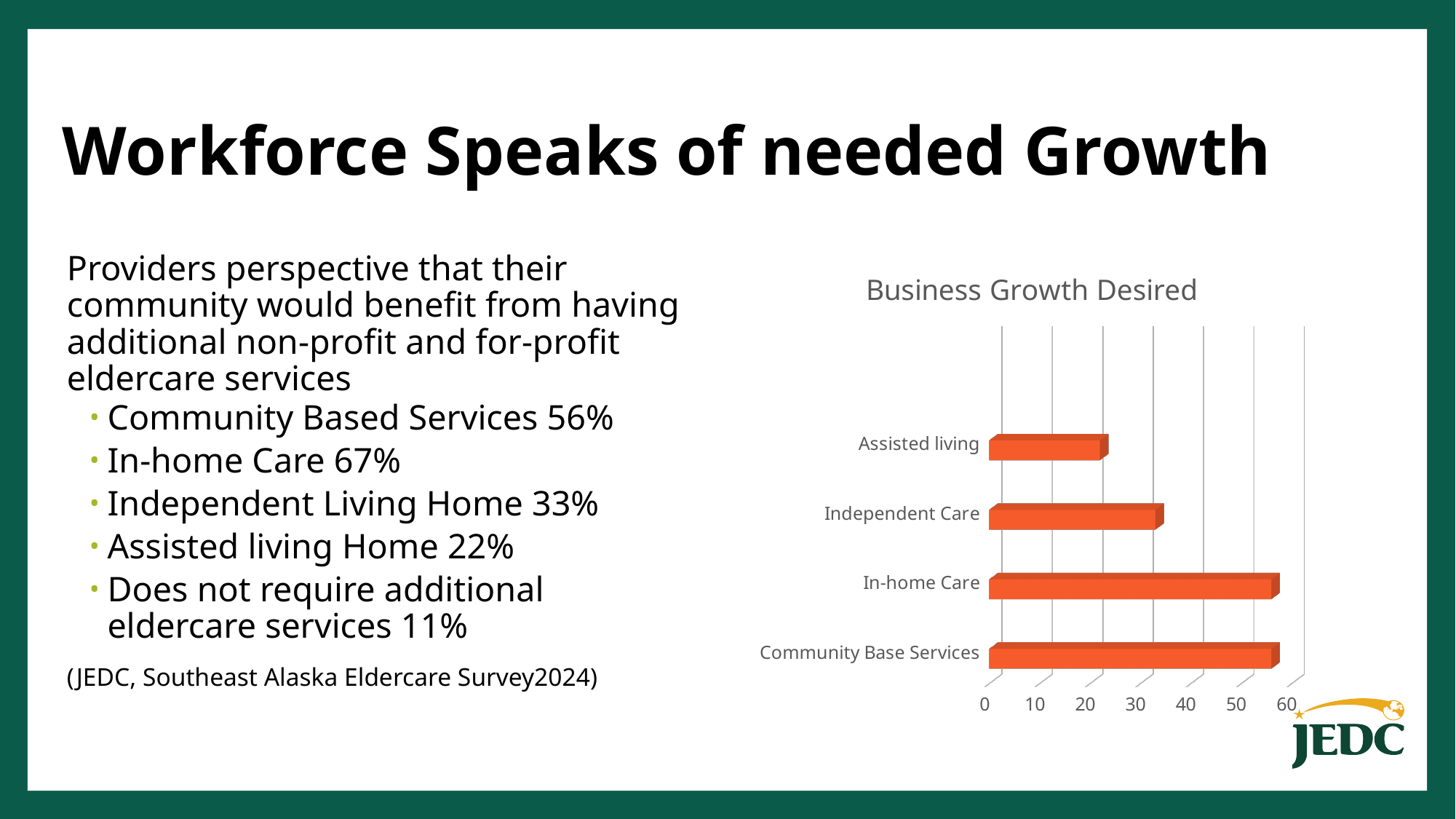
How many categories are plotted in the chart? 4 What type of chart is shown on the slide? bar chart Is the value for In-home Care greater or less than 50? greater Which category has the lowest value in the chart? Assisted living Is the value for Independent Care greater or less than 40? less Is the value for Assisted living greater or less than 30? less Which is larger, the value for Independent Care or the value for In-home Care? In-home Care What is the highest value shown on the horizontal axis of the chart? 60 Which is larger, the value for Assisted living or the value for Independent Care? Independent Care What is the title of the chart? Business Growth Desired